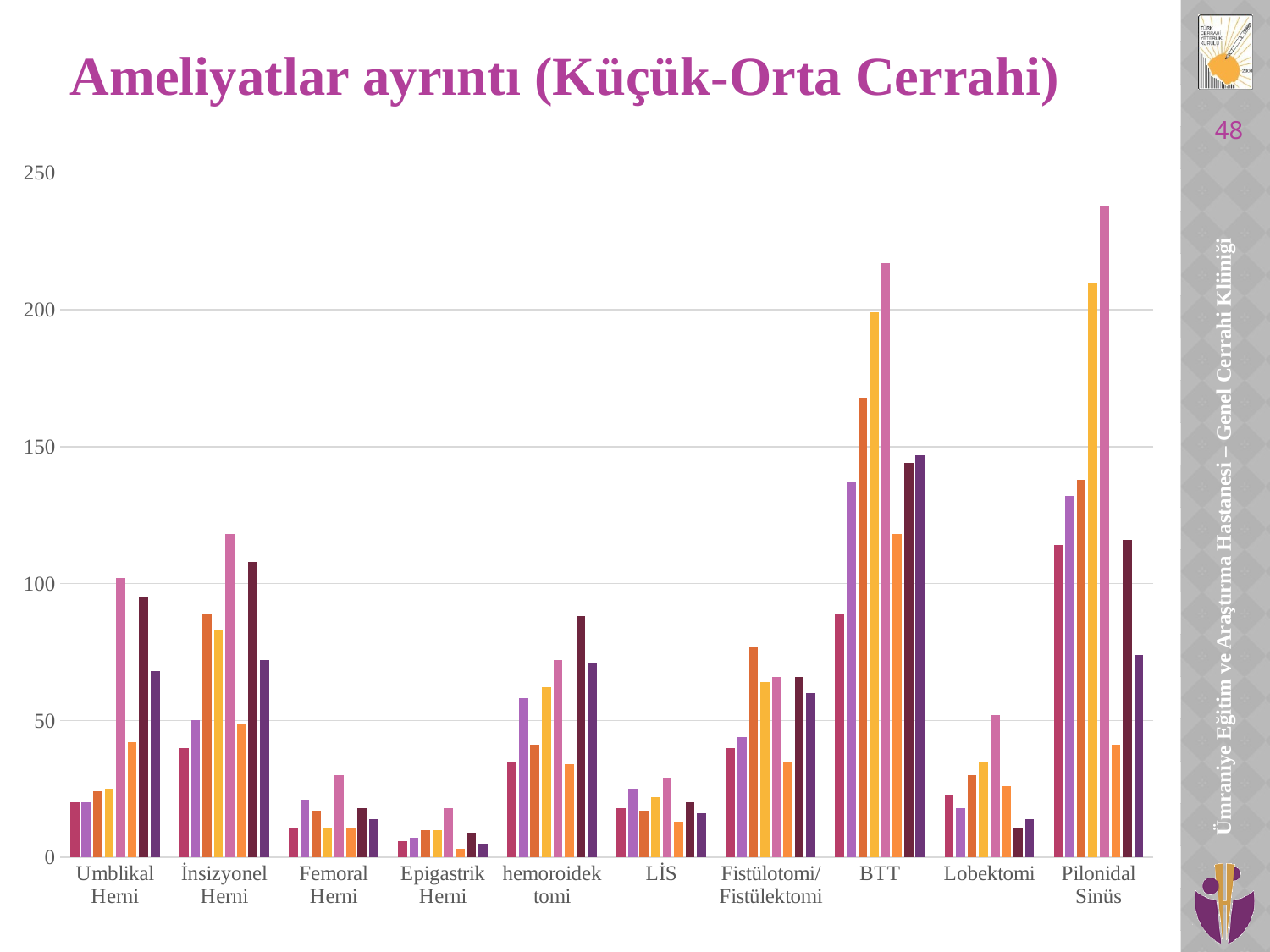
How many categories are shown along the x axis of the chart? 10 What is the highest value shown on the y axis of the chart? 250 Is the tallest bar for İnsizyonel Herni greater or less than 100? greater How many bars are plotted for each category in the chart? 8 Is the tallest bar for BTT greater or less than 200? greater Which category has the taller tallest bar, BTT or Lobektomi? BTT Are all the bars for Epigastrik Herni greater or less than 50? less What kind of chart is shown on the slide? bar chart Which category has the lowest bars overall in the chart? Epigastrik Herni What is the title of the chart slide? Ameliyatlar ayrıntı (Küçük-Orta Cerrahi) Which category contains the tallest bar in the chart? Pilonidal Sinüs